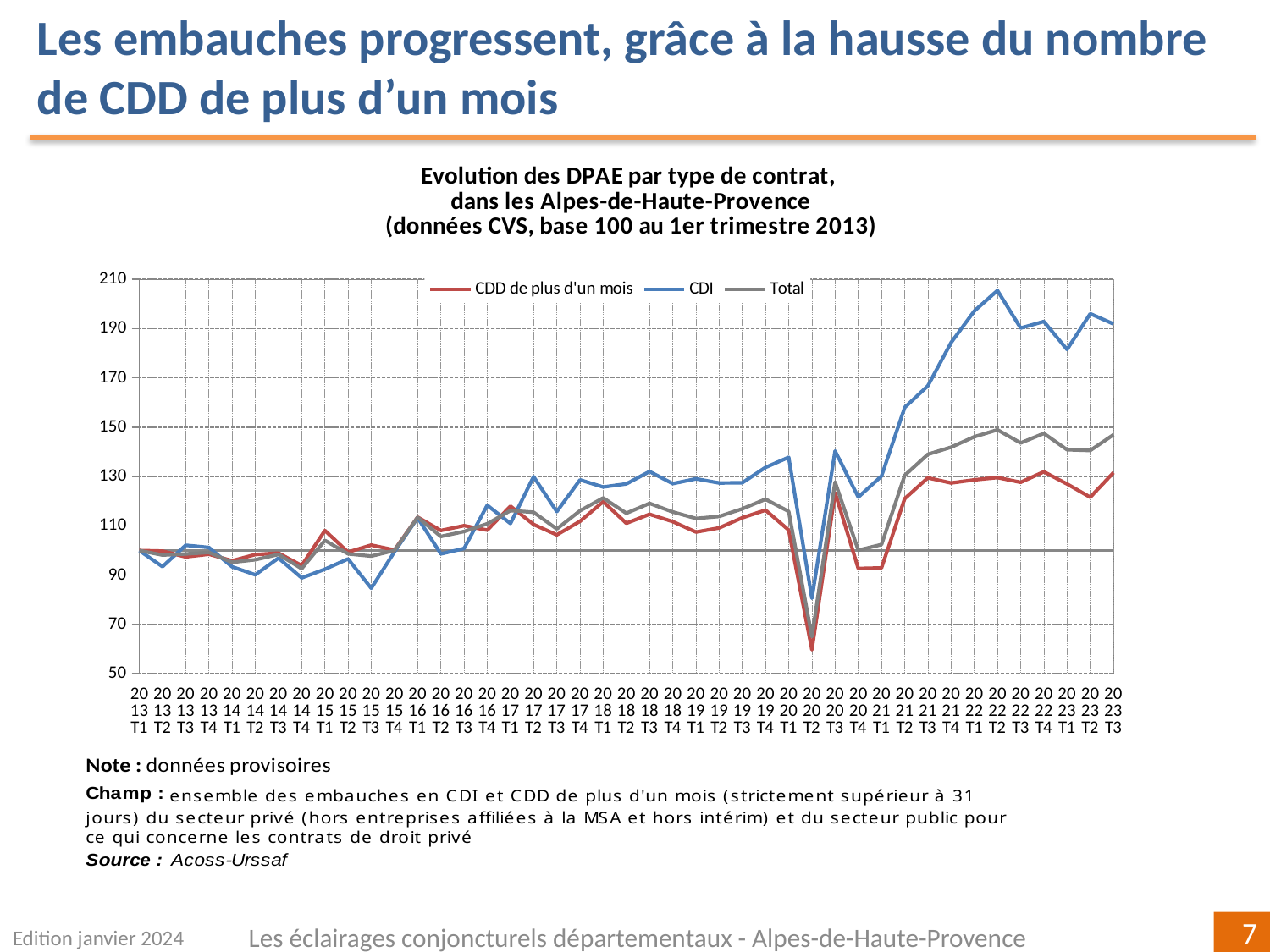
How many quarterly points are plotted along the x axis, from 2013 T1 to 2023 T3? 43 How many series does the legend list? 3 Does the CDI series rise or fall between 2020 T4 and 2022 T2? rise Is the value of the Total series at 2023 T3 greater or less than 130? greater Is the value of the CDI series at 2022 T2 greater or less than 190? greater Which series has the highest value at 2023 T3? CDI Which series are listed in the legend? CDD de plus d'un mois, CDI, Total At 2023 T3, which is larger: the CDI series or the CDD de plus d'un mois series? CDI In which quarter does the CDD de plus d'un mois series reach its lowest value? 2020 T2 What is the value of the Total series at 2013 T1, the base quarter? 100 What kind of chart is shown on the slide? line chart Is the value of the CDD de plus d'un mois series at 2020 T2 greater or less than 70? less